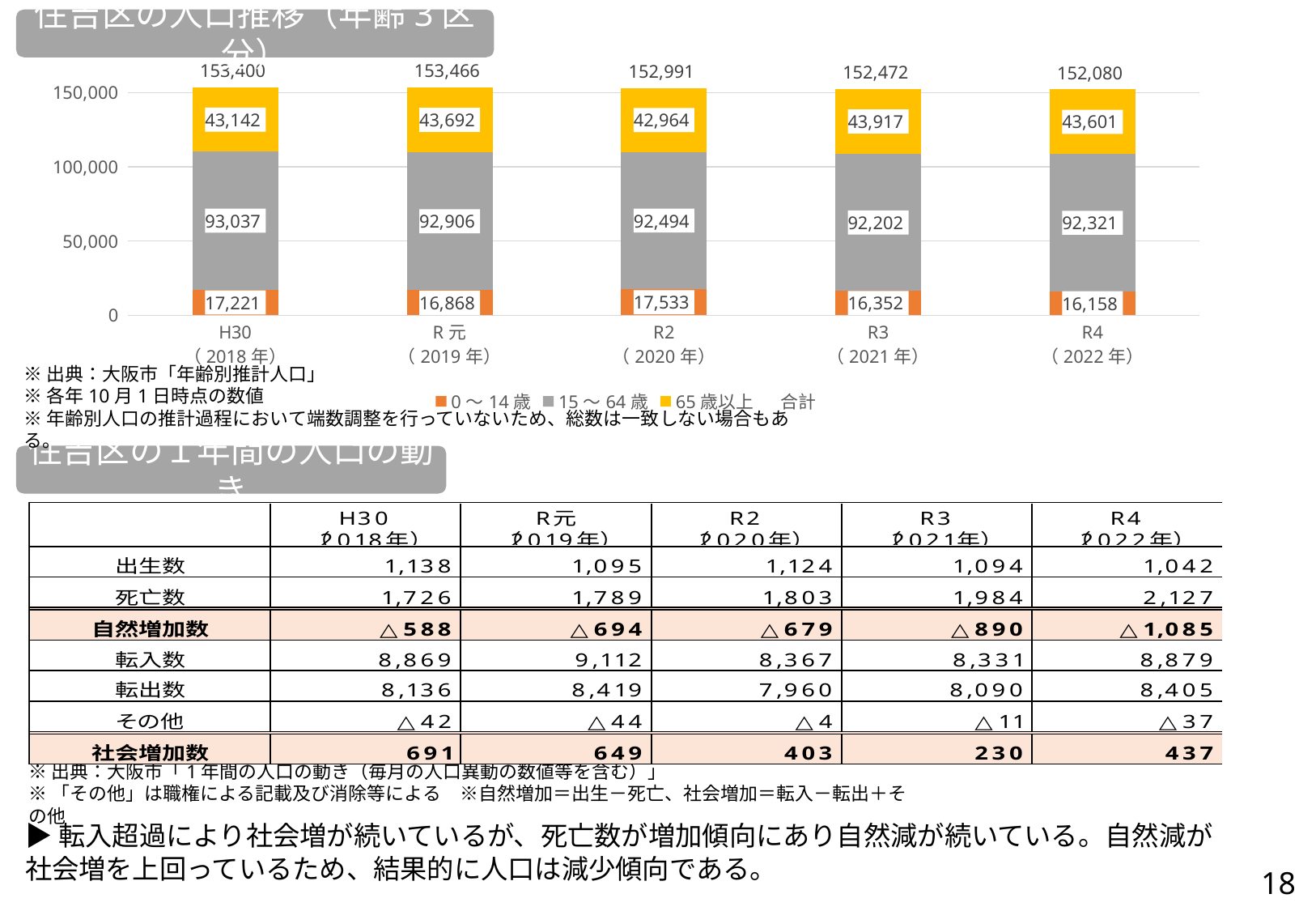
How many age-group series are stacked in each bar of the population chart? 3 In the population chart, is the 15～64歳 value larger in H30 (2018年) or in R4 (2022年)? H30 (2018年) What type of chart is shown on the slide? Stacked bar chart In the population chart, what is the total (合計) printed above the bar for R2 (2020年)? 152,991 In the population chart, what is the difference between the 65歳以上 values for R元 (2019年) and R2 (2020年)? 728 In the population chart, what is the value for 65歳以上 in R3 (2021年)? 43,917 In the population chart, what is the value for 0～14歳 in R4 (2022年)? 16,158 In the population chart, does the total (合計) rise or fall from R元 (2019年) to R4 (2022年)? Fall In the population chart, what is the value for 15～64歳 in H30 (2018年)? 93,037 In the population chart, which year has the highest value for 0～14歳? R2 (2020年) How many years (bars) are shown in the population chart? 5 In the population chart, which year has the lowest total (合計)? R4 (2022年)